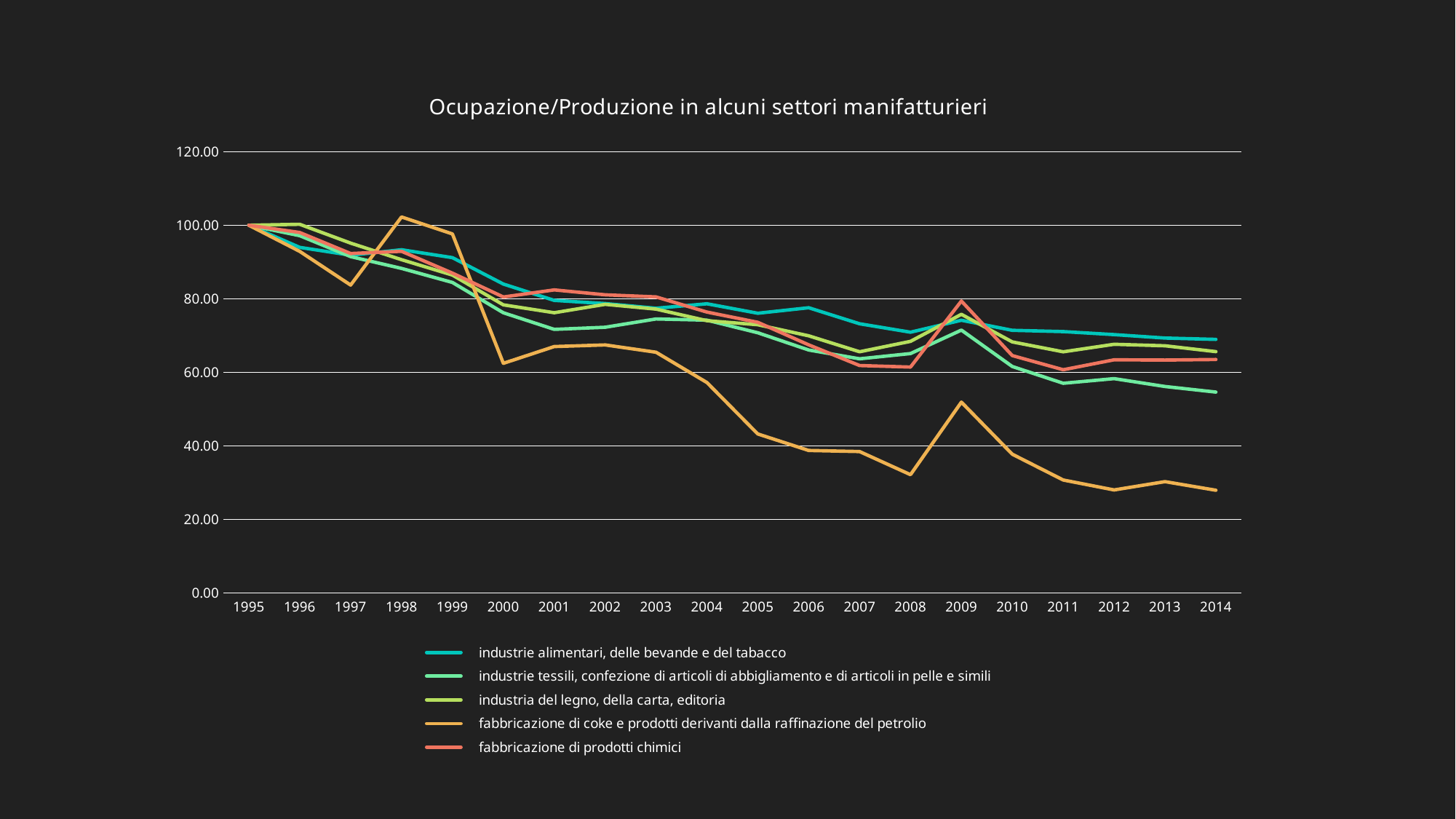
What kind of chart is shown on the slide? line chart How many years are plotted along the x axis? 20 What is the value of the 'fabbricazione di prodotti chimici' series in 1995? 100.00 Is the value for 'fabbricazione di coke e prodotti derivanti dalla raffinazione del petrolio' in 2014 greater or less than 40.00? less Is the value for 'fabbricazione di coke e prodotti derivanti dalla raffinazione del petrolio' in 2009 greater or less than 40.00? greater In 2008, which is larger: the value for 'industrie tessili, confezione di articoli di abbigliamento e di articoli in pelle e simili' or the value for 'fabbricazione di coke e prodotti derivanti dalla raffinazione del petrolio'? industrie tessili, confezione di articoli di abbigliamento e di articoli in pelle e simili What is the value of the 'industrie alimentari, delle bevande e del tabacco' series in 1995? 100.00 Is the value for 'industrie alimentari, delle bevande e del tabacco' in 2014 greater or less than 60.00? greater Which series has the highest value in 2014? industrie alimentari, delle bevande e del tabacco How many series does the legend list? 5 Which series has the lowest value in 2014? fabbricazione di coke e prodotti derivanti dalla raffinazione del petrolio Does the 'fabbricazione di coke e prodotti derivanti dalla raffinazione del petrolio' series rise or fall overall from 1995 to 2014? fall